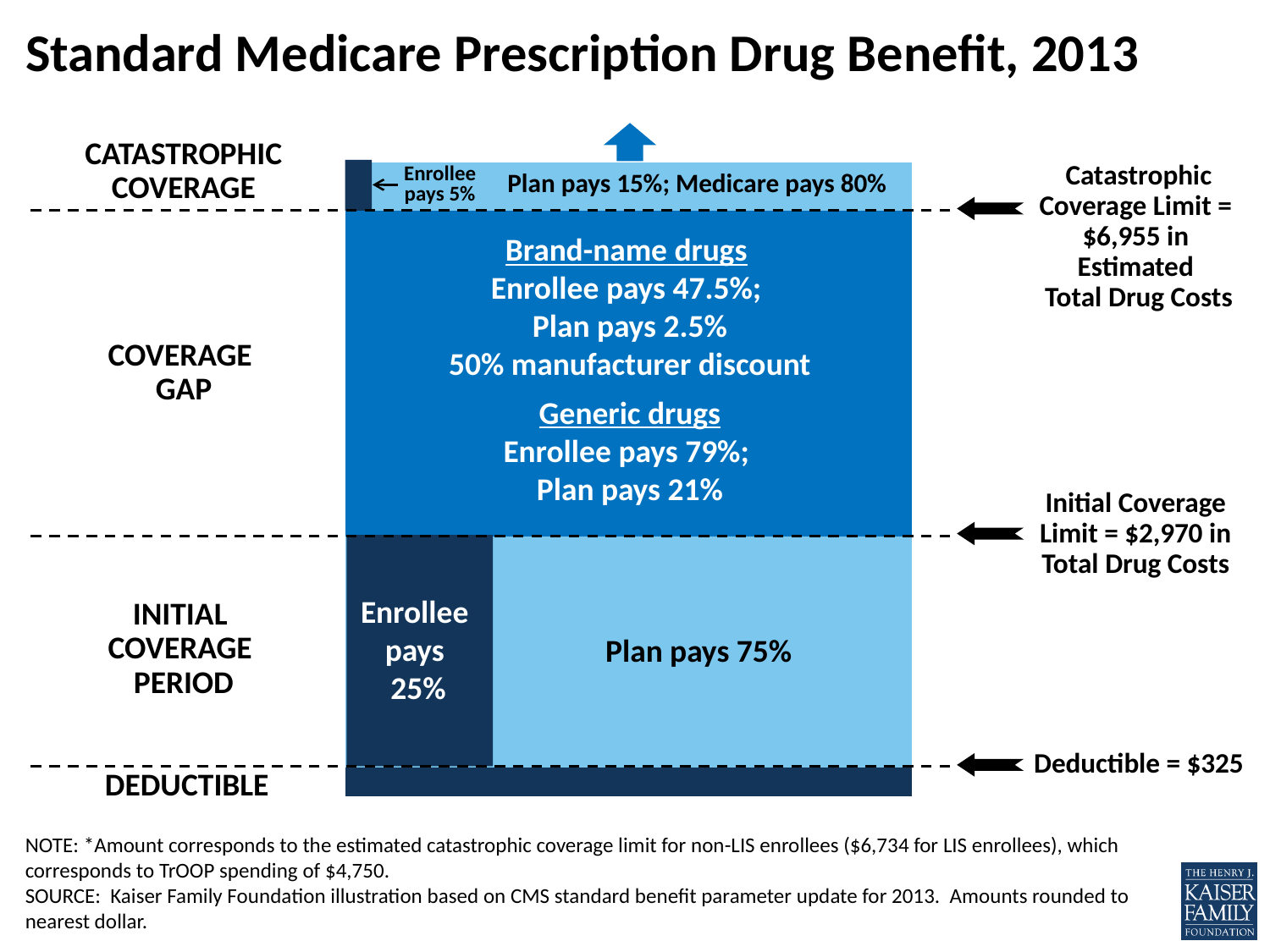
In the Initial Coverage Period, what percentage does the enrollee pay? 25% In Catastrophic Coverage, what percentage does Medicare pay? 80% What is the Catastrophic Coverage Limit in estimated total drug costs? $6,955 What is the Initial Coverage Limit in total drug costs? $2,970 In the Coverage Gap, what percentage does the plan pay for generic drugs? 21% What is the title of the chart on the slide? Standard Medicare Prescription Drug Benefit, 2013 In the Coverage Gap, what percentage does the enrollee pay for generic drugs? 79% In the Coverage Gap, what percentage does the enrollee pay for brand-name drugs? 47.5% What is the deductible amount shown on the slide? $325 In the Initial Coverage Period, what percentage does the plan pay? 75% In Catastrophic Coverage, what percentage does the enrollee pay? 5% How many benefit phases are labeled on the left side of the chart? 4